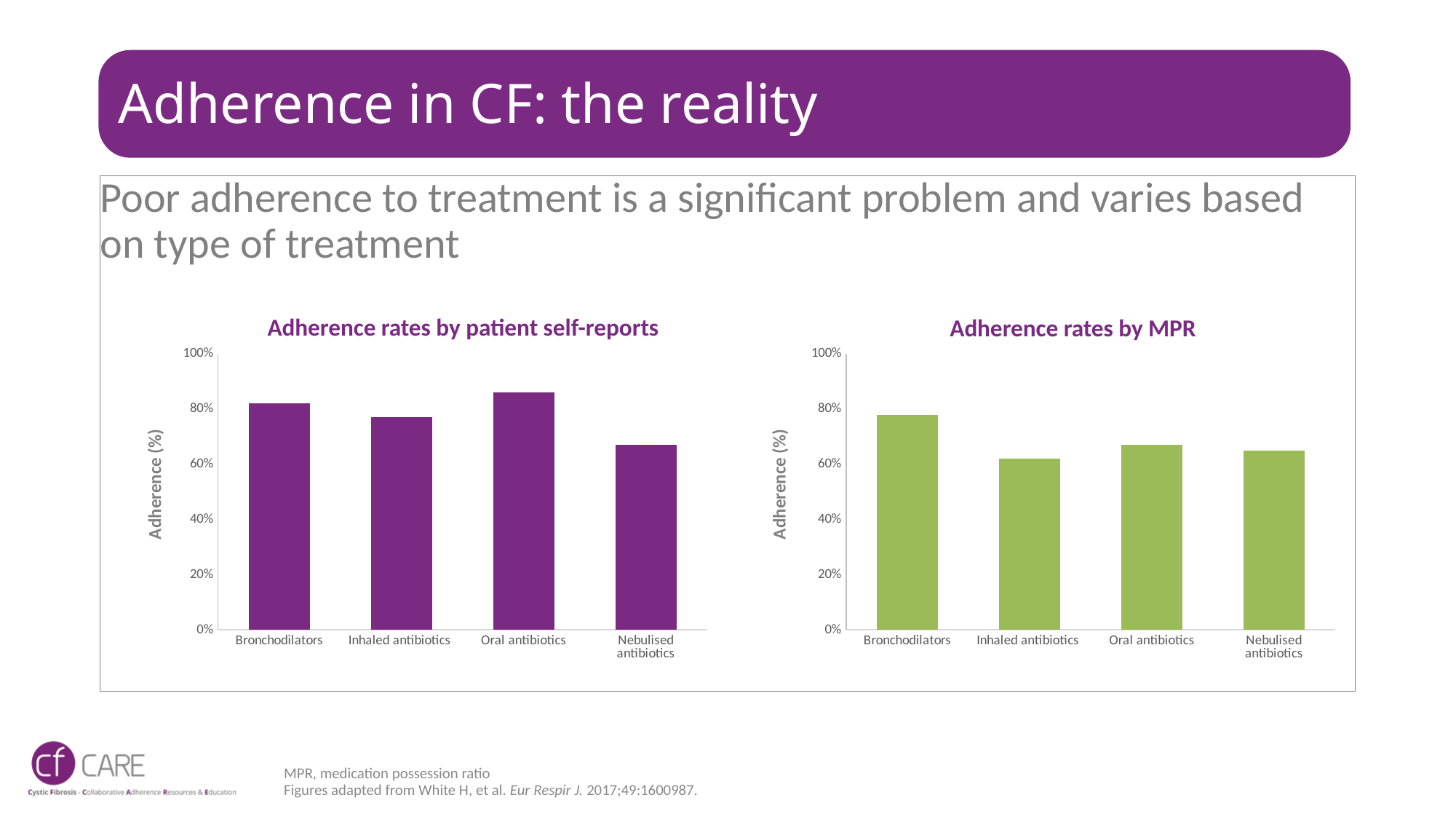
In the "Adherence rates by MPR" chart, is the value for Inhaled antibiotics greater or less than 80%? less In the "Adherence rates by patient self-reports" chart, is the value for Oral antibiotics greater or less than 80%? greater In the "Adherence rates by patient self-reports" chart, which treatment has the highest adherence? Oral antibiotics In the "Adherence rates by MPR" chart, which treatment has the highest adherence? Bronchodilators How many treatment categories are shown in the "Adherence rates by MPR" chart? 4 In the "Adherence rates by patient self-reports" chart, which treatment has the lowest adherence? Nebulised antibiotics In the "Adherence rates by MPR" chart, which is larger: Bronchodilators or Oral antibiotics? Bronchodilators In the "Adherence rates by patient self-reports" chart, is the value for Nebulised antibiotics greater or less than 60%? greater What kind of chart is "Adherence rates by patient self-reports"? bar chart In the "Adherence rates by patient self-reports" chart, which is larger: Inhaled antibiotics or Nebulised antibiotics? Inhaled antibiotics What colour are the bars in the "Adherence rates by MPR" chart? green